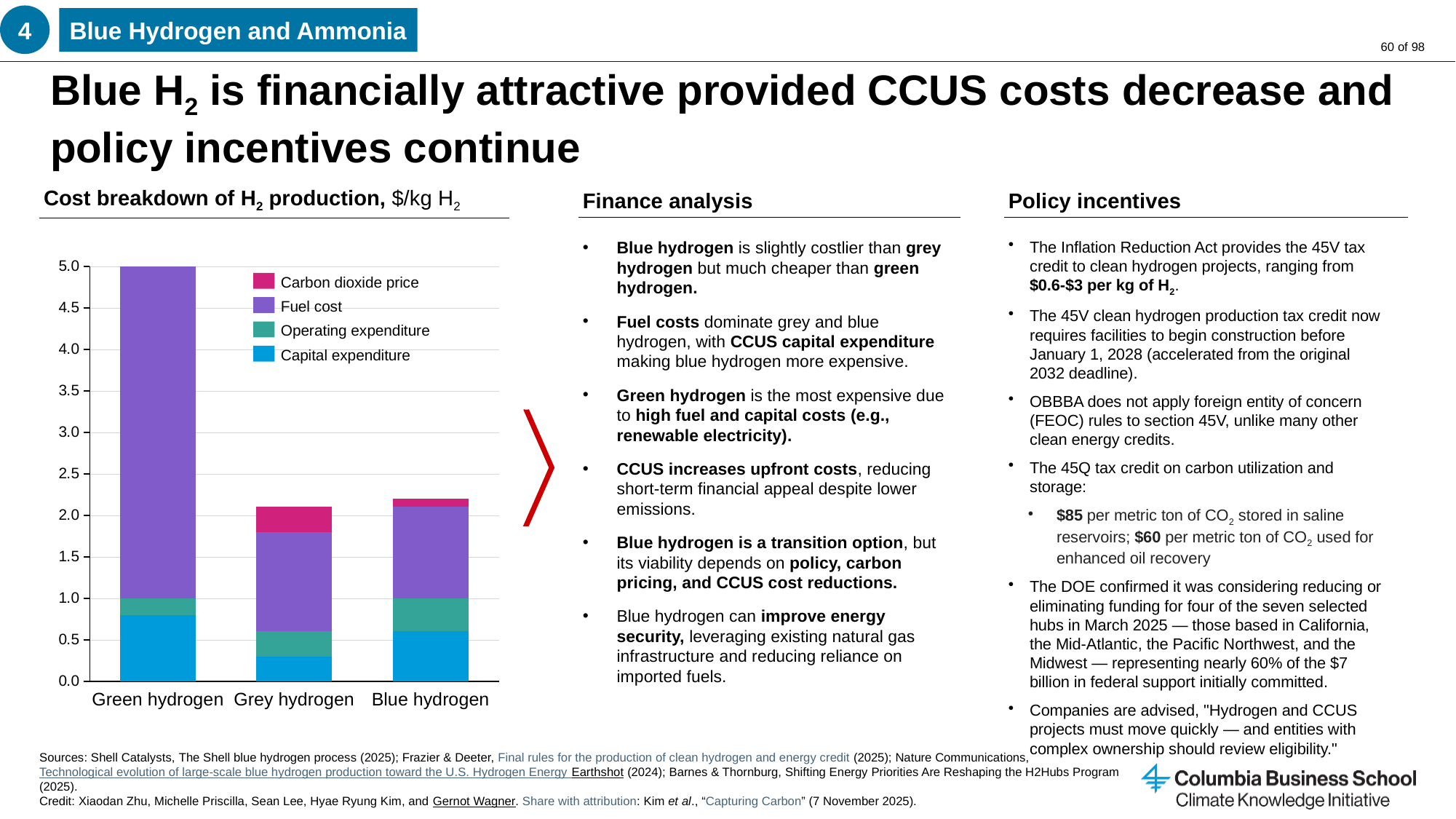
Which cost component is the largest segment of the green hydrogen bar? Fuel cost How many series does the legend of the cost breakdown chart list? 4 Which has a larger capital expenditure segment, green hydrogen or grey hydrogen? Green hydrogen What kind of chart is shown under 'Cost breakdown of H2 production'? Bar chart Which hydrogen category has the highest total cost in the cost breakdown chart? Green hydrogen Is the total cost for grey hydrogen greater or less than 2.5? less Is the total cost for green hydrogen greater or less than 4.5? greater Which has a larger total cost, green hydrogen or grey hydrogen? Green hydrogen How many hydrogen categories are shown on the x axis of the cost breakdown chart? 3 What is the total cost of green hydrogen in $/kg H2 according to the chart? 5.0 Is the total cost for blue hydrogen greater or less than 3.0? less What colour represents fuel cost in the cost breakdown chart's legend? Purple